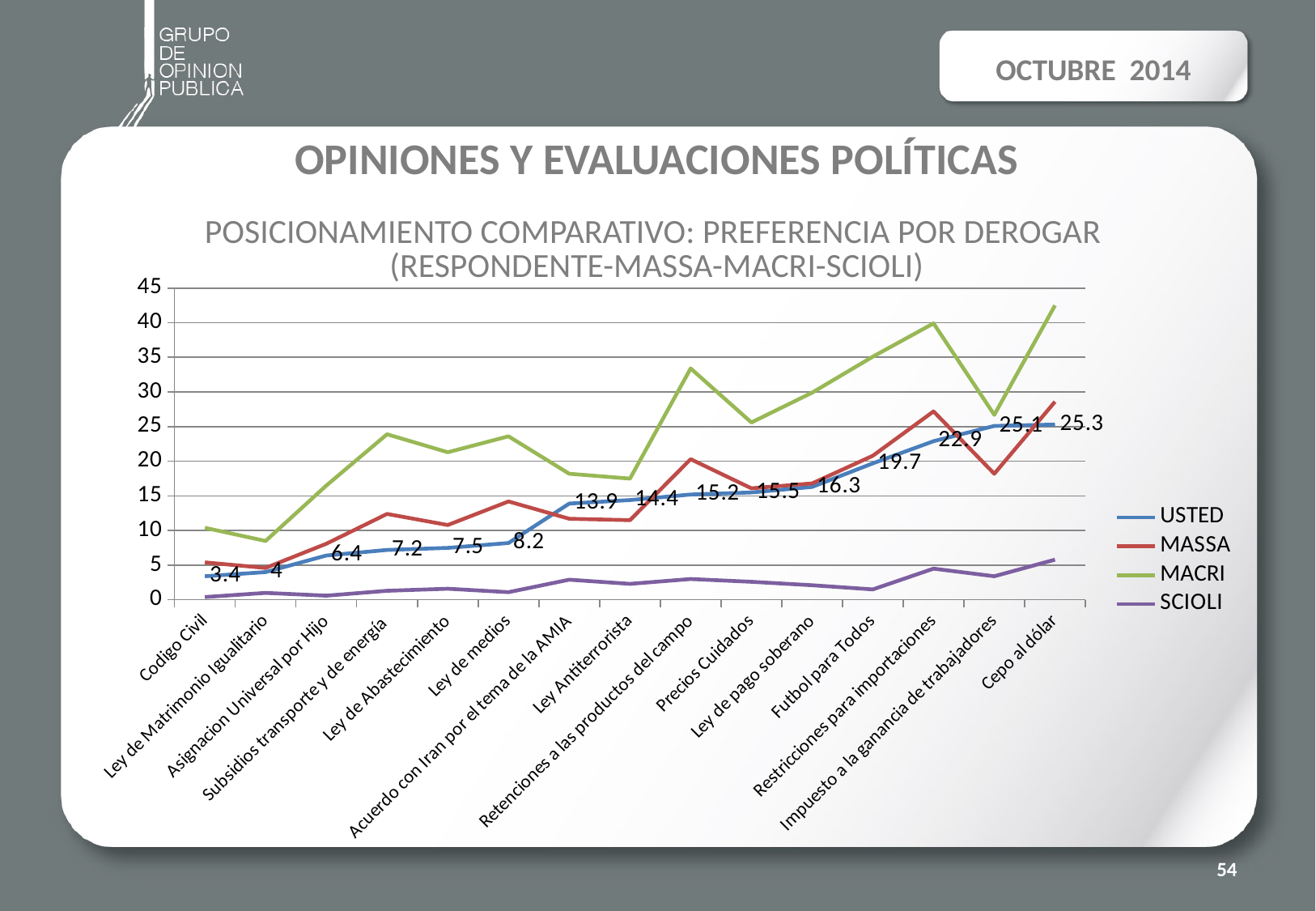
Which category has the lowest USTED value? Codigo Civil How many categories are plotted along the x axis? 15 What is the USTED value for Futbol para Todos? 19.7 Do the USTED values rise or fall from Codigo Civil to Cepo al dólar? rise What is the USTED value for Ley de medios? 8.2 Which series is higher for Precios Cuidados, MACRI or SCIOLI? MACRI Which category has the highest USTED value? Cepo al dólar Is the MACRI value for Cepo al dólar greater or less than 40? greater What is the difference between the USTED values for Restricciones para importaciones and Ley Antiterrorista? 8.5 What type of chart is shown on the slide? line chart How many series does the legend list? 4 What is the USTED value for Cepo al dólar? 25.3